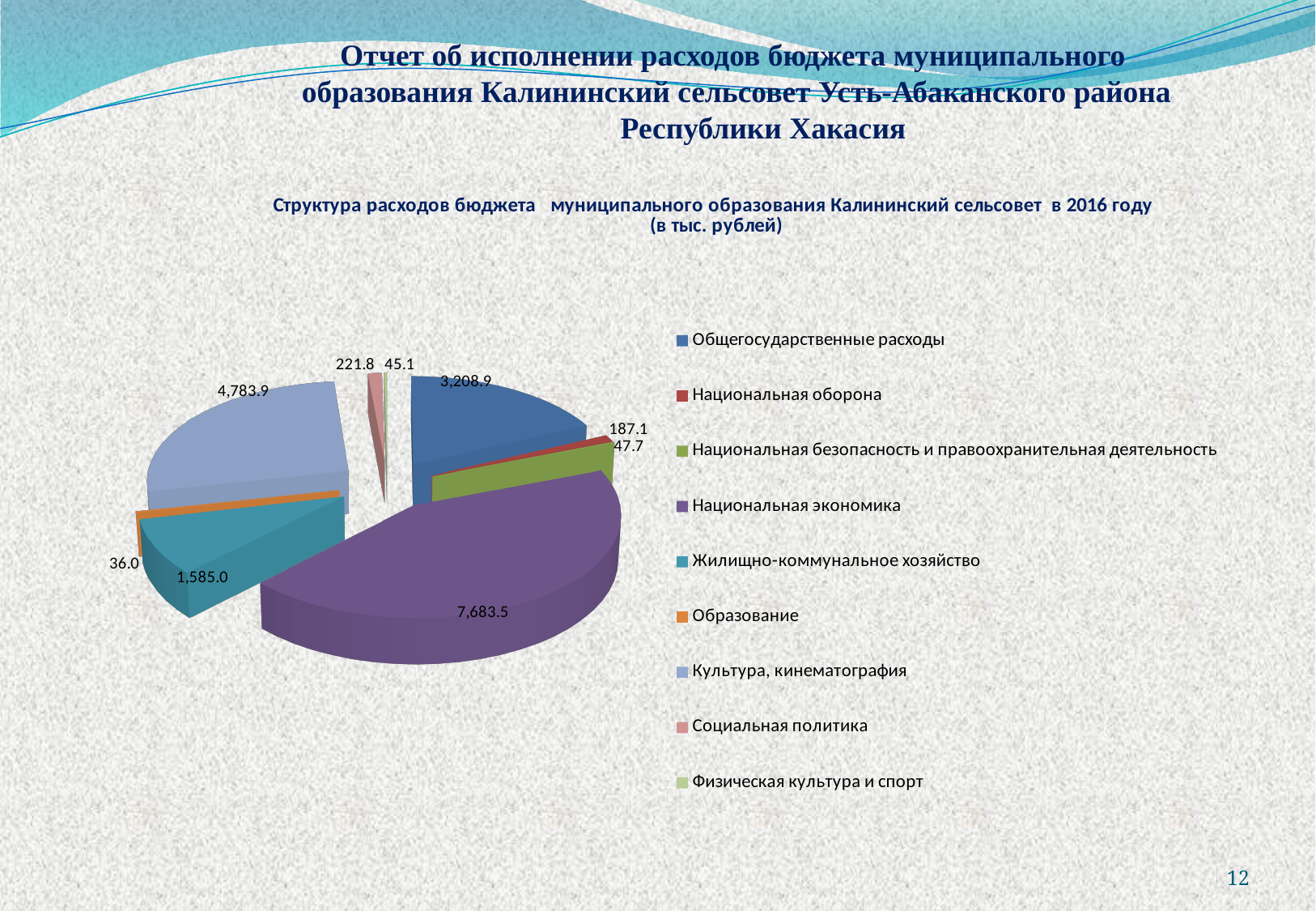
What is the value for Образование? 36.0 Which category has the largest share of the pie? Национальная экономика How many categories does the legend of the pie chart list? 9 Which is larger: Общегосударственные расходы or Культура, кинематография? Культура, кинематография What is the value for Национальная экономика? 7,683.5 What is the value for Общегосударственные расходы? 3,208.9 What is the value for Культура, кинематография? 4,783.9 Which category has the smallest value in the pie chart? Образование What is the difference between the values for Национальная экономика and Культура, кинематография? 2,899.6 What is the value for Жилищно-коммунальное хозяйство? 1,585.0 What is the value for Социальная политика? 221.8 What type of chart is shown on the slide? Pie chart